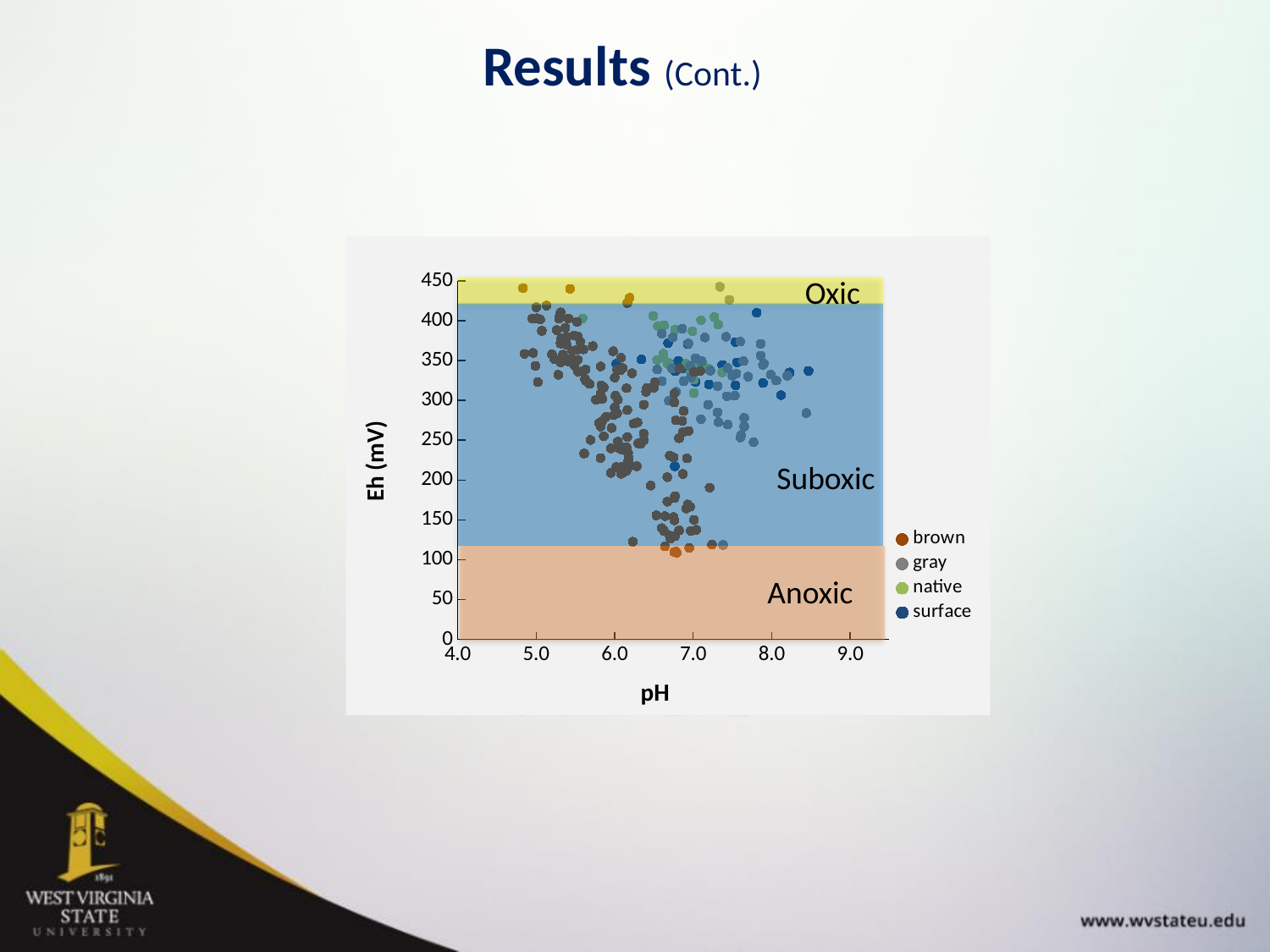
What are the series names listed in the legend? brown, gray, native, surface Is the lowest Eh value among the brown points greater or less than 150? less What are the three zone labels shown on the chart background? Oxic, Suboxic, Anoxic How many tick labels are shown on the pH axis? 6 Is the lowest Eh value among the gray points greater or less than 150? less Is the highest Eh value among the brown points greater or less than 400? greater How many tick labels are shown on the Eh (mV) axis? 10 What kind of chart is shown on the slide? scatter chart How many series does the legend list? 4